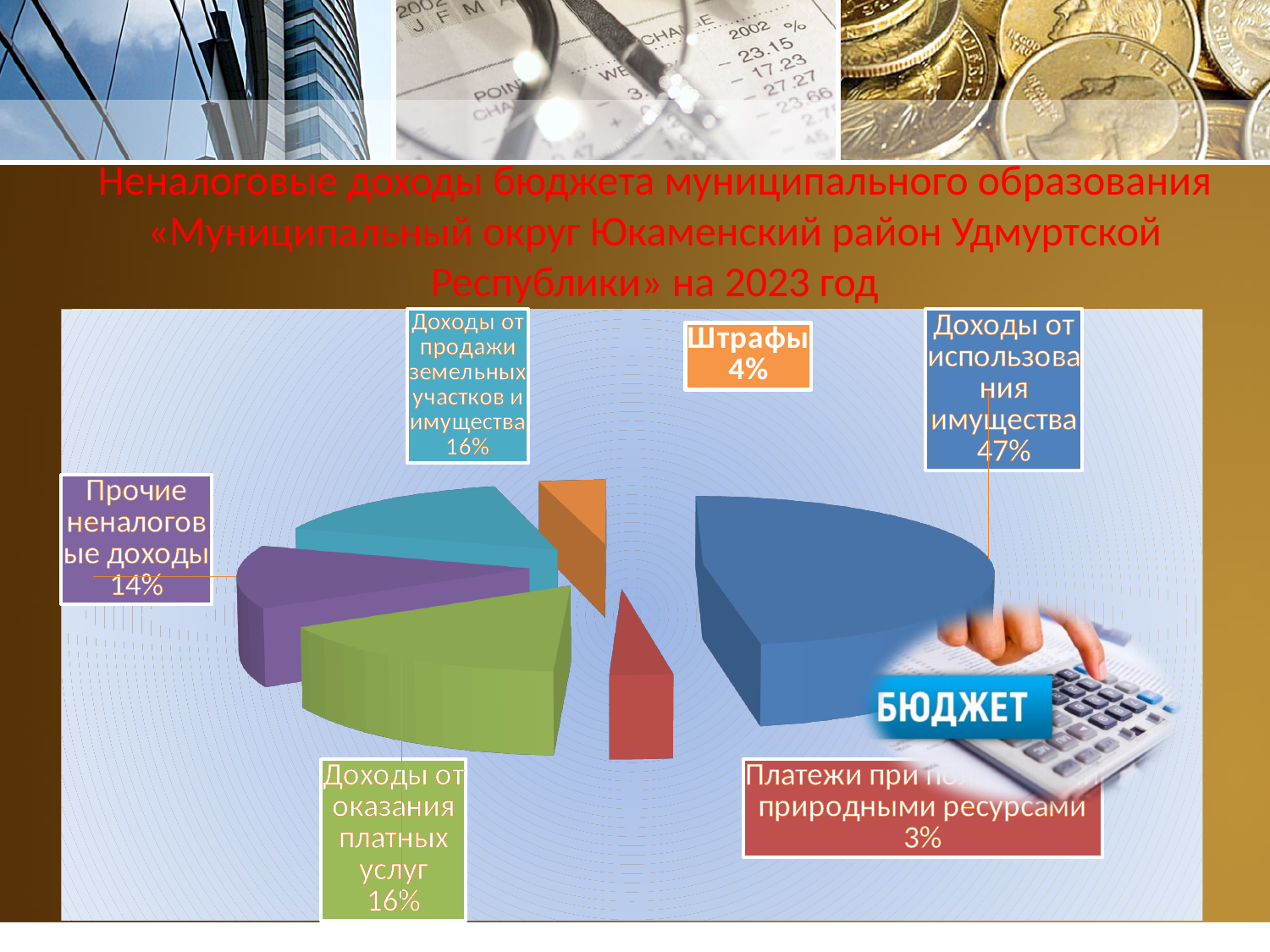
What is the value shown for «Доходы от оказания платных услуг»? 16% What is the value shown for «Доходы от продажи земельных участков и имущества»? 16% What is the difference between the shares of «Доходы от использования имущества» and «Прочие неналоговые доходы»? 33% What is the value shown for «Прочие неналоговые доходы»? 14% What is the value shown for «Штрафы»? 4% Which category has the largest share of the pie? Доходы от использования имущества What share of the pie does «Доходы от использования имущества» have? 47% How many slices does the pie chart have? 6 Which is larger: the share for «Штрафы» or the share for «Прочие неналоговые доходы»? Прочие неналоговые доходы What kind of chart is shown on the slide? Pie chart Which category has the smallest share of the pie? Платежи при пользовании природными ресурсами What colour is the slice for «Доходы от использования имущества»? Blue